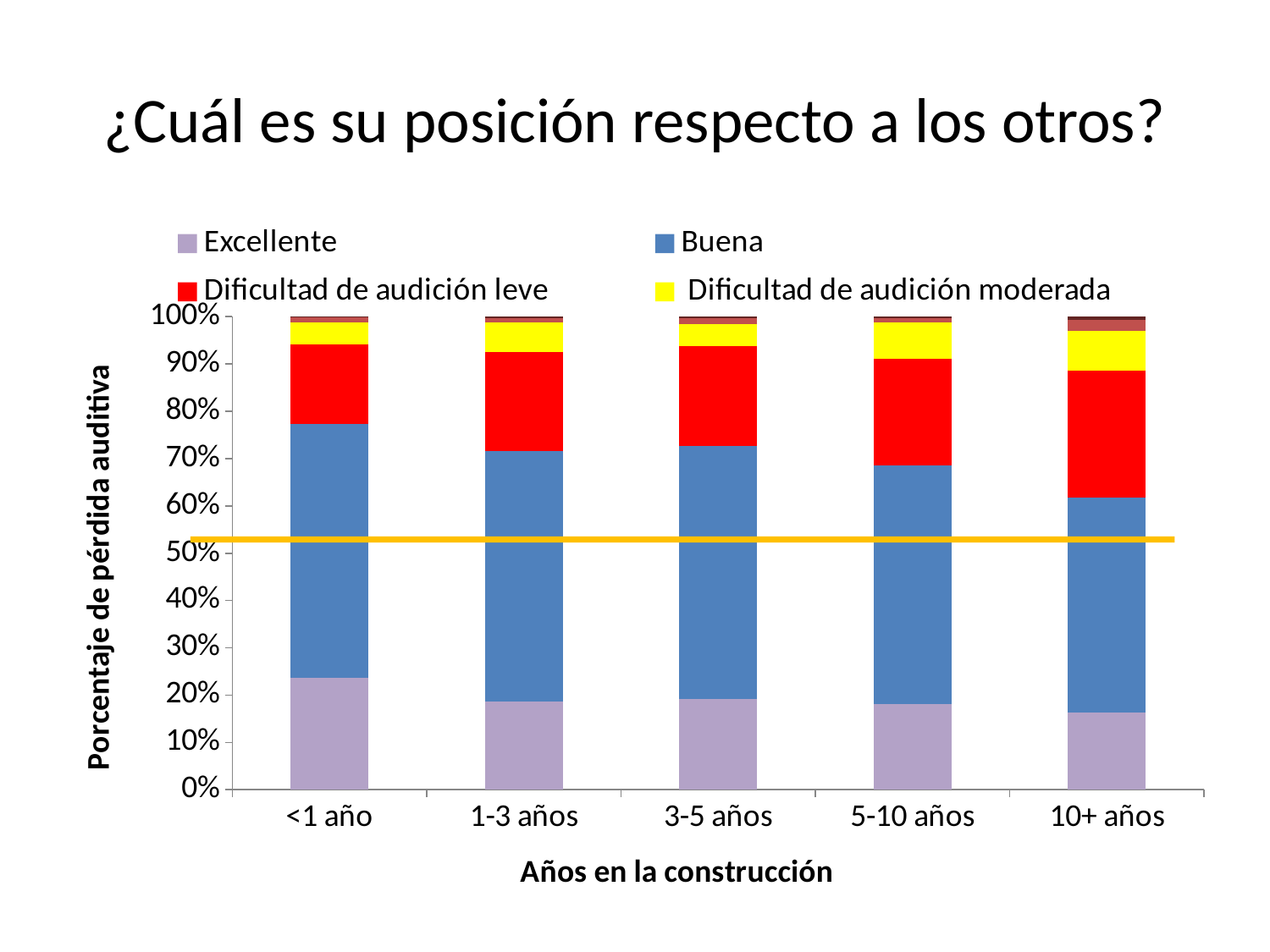
Is the Excellente segment for <1 año greater or less than 20%? greater How many series does the chart's legend list? 4 Does the top of the Buena segment for 10+ años reach above or below 70%? below Which category has the largest Excellente segment? <1 año How many categories are shown on the x axis of the chart? 5 Which category has the larger Excellente segment, <1 año or 10+ años? <1 año Is the Excellente segment for 10+ años greater or less than 20%? less Which category has the larger Dificultad de audición leve segment, <1 año or 10+ años? 10+ años What is the label of the x axis of the chart? Años en la construcción What is the label of the y axis of the chart? Porcentaje de pérdida auditiva What kind of chart is shown on the slide? Stacked bar chart